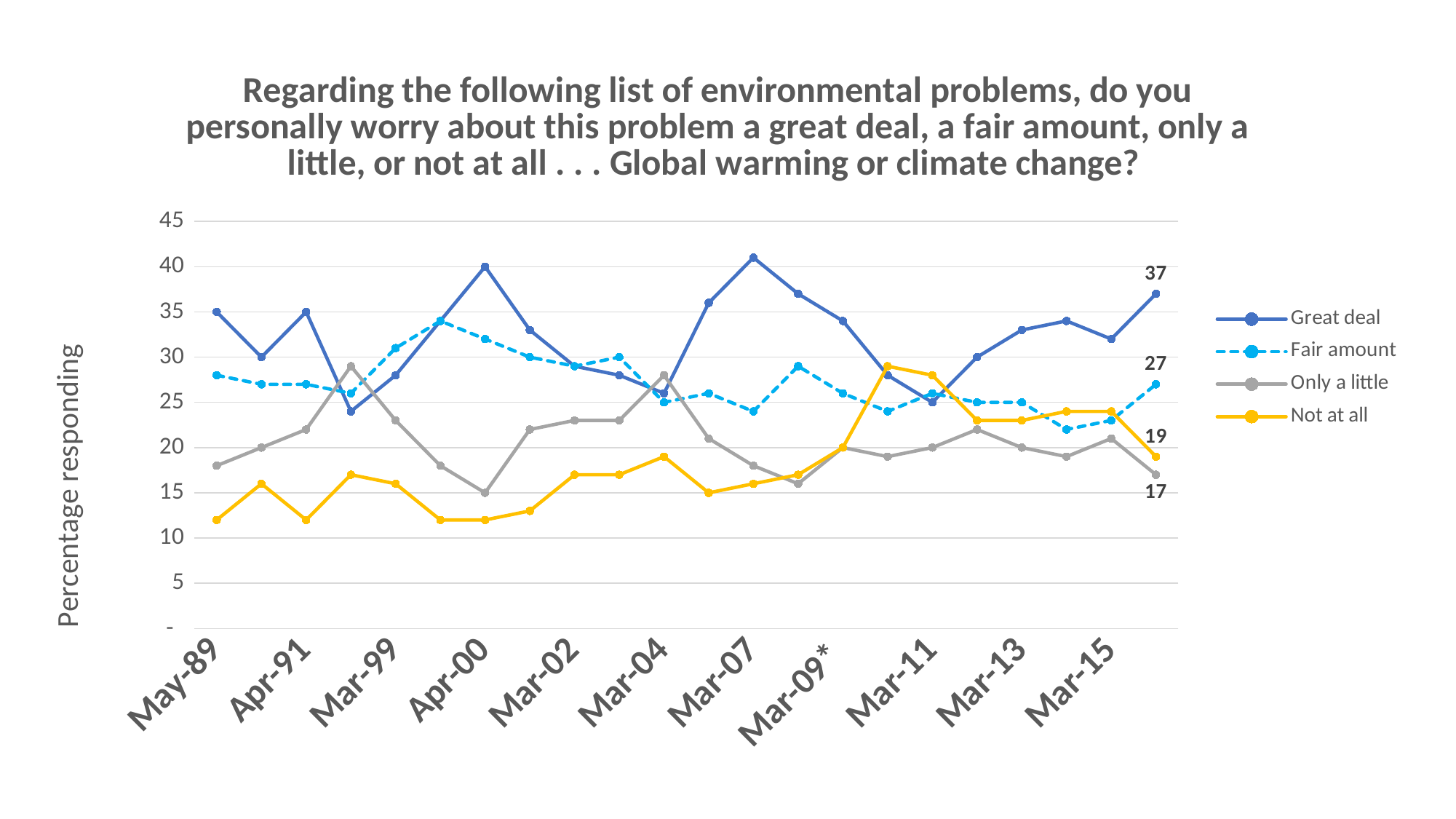
How many series does the legend list? 4 At the final data point, which is larger: Not at all or Only a little? Not at all Which series has the highest value at the final data point? Great deal Is the value for Not at all at Apr-00 greater or less than 15? less What is the labelled value for Only a little at the final data point on the right? 17 Which series has the lowest value at the final data point? Only a little What is the labelled value for Not at all at the final data point on the right? 19 What is the labelled value for Fair amount at the final data point on the right? 27 What is the labelled value for Great deal at the final data point on the right? 37 What is the title of the vertical axis? Percentage responding At the final data point, what is the difference between the Great deal value and the Fair amount value? 10 What kind of chart is shown on the slide? line chart